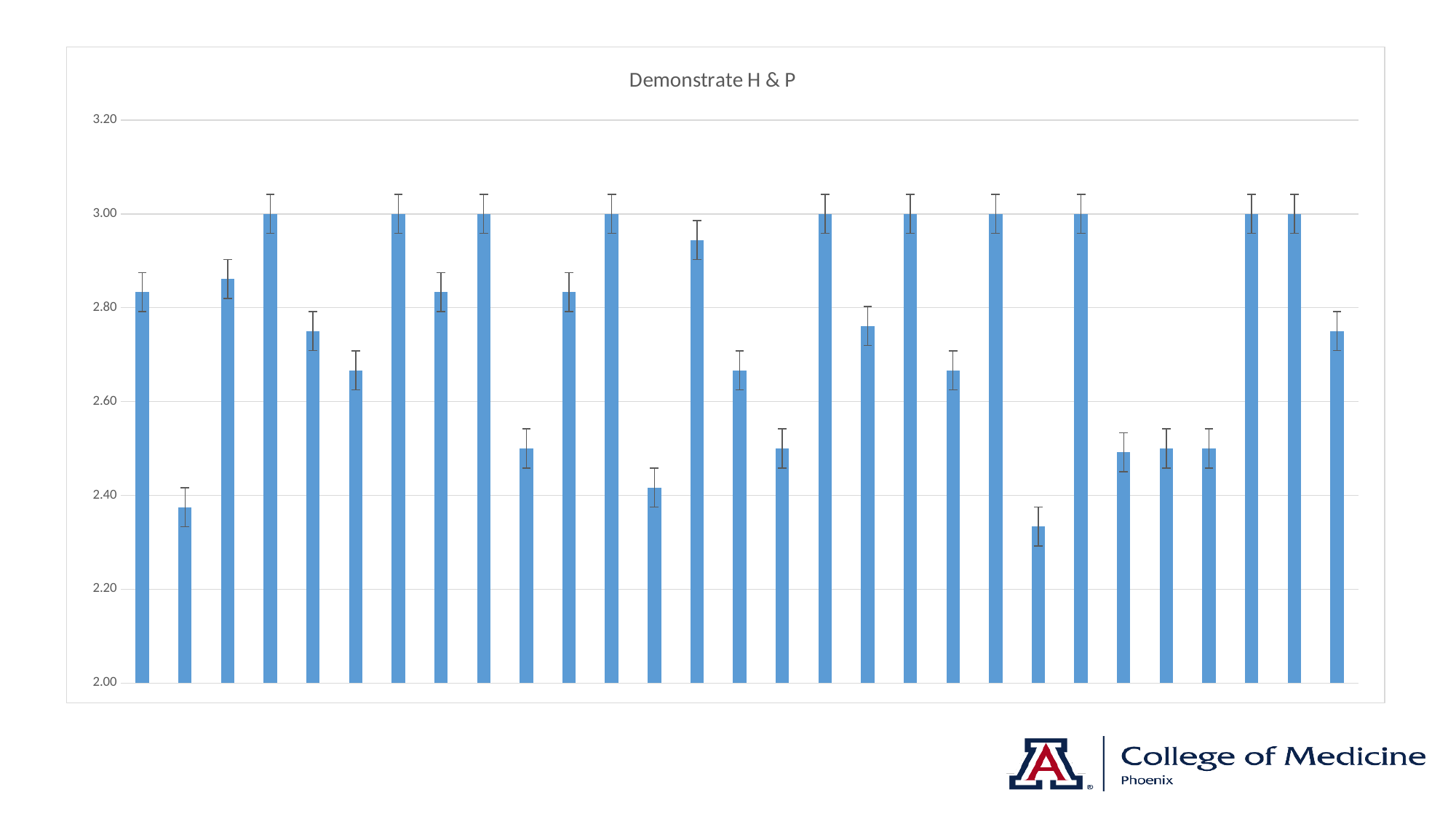
What value does the fourth bar from the left reach? 3.00 What kind of chart is shown on the slide? bar chart Is the value of the fifth bar from the left greater or less than 2.60? greater How many bars reach the 3.00 gridline? 10 Is the value of the last bar on the right greater or less than 2.80? less Is the value of the first bar from the left greater or less than 2.60? greater How many bars are plotted in the chart? 29 What is the title of the chart? Demonstrate H & P Which is larger, the first bar from the left or the second bar from the left? the first bar What is the lowest value shown on the vertical axis? 2.00 What is the highest value reached by any bar in the chart? 3.00